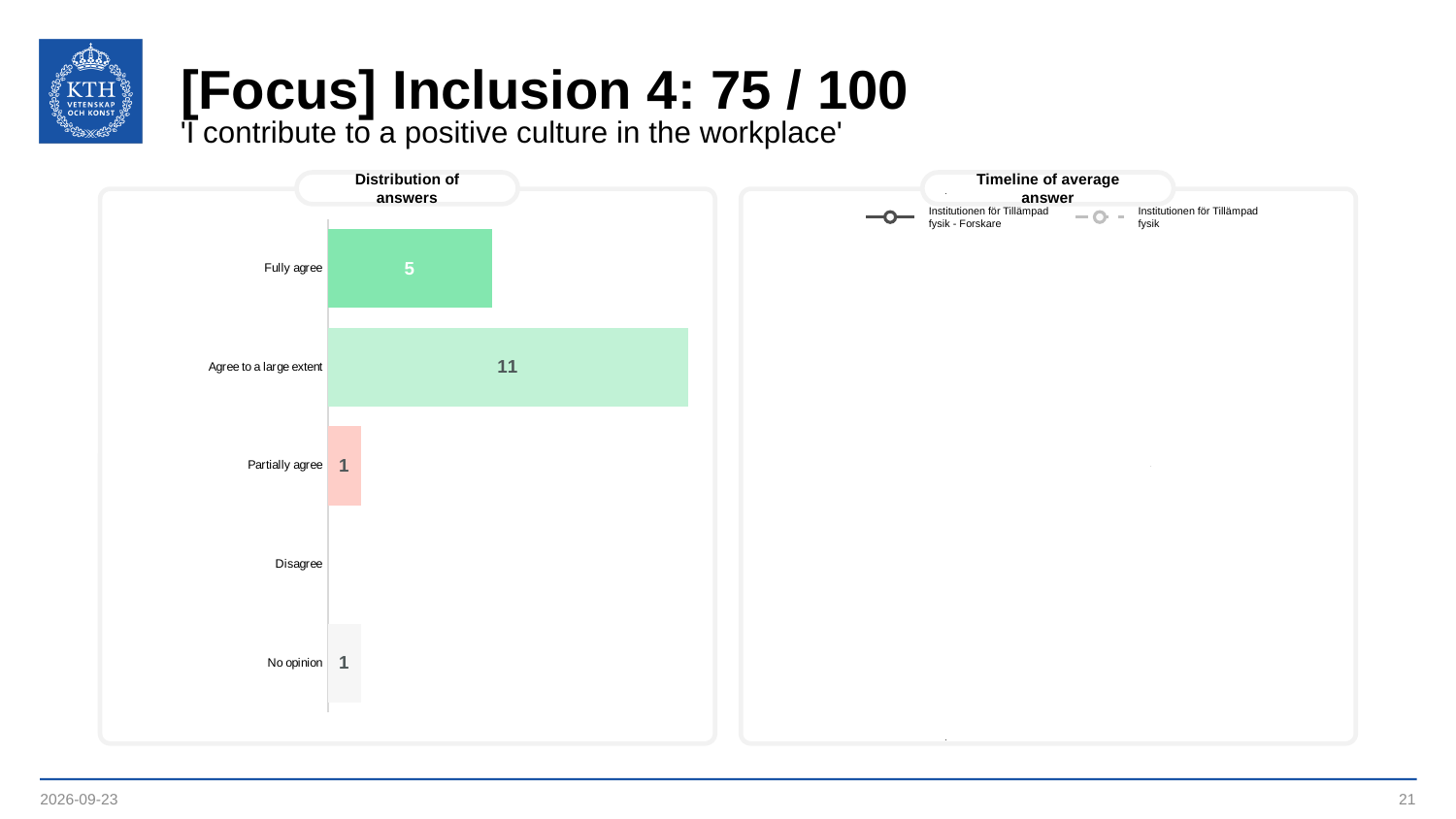
What is the first legend entry in the 'Timeline of average answer' chart? Institutionen för Tillämpad fysik - Forskare In the 'Distribution of answers' chart, what is the value for 'Fully agree'? 5 In the 'Distribution of answers' chart, what is the difference between the values for 'Agree to a large extent' and 'Fully agree'? 6 What kind of chart is the 'Distribution of answers' chart? Bar chart How many series does the legend of the 'Timeline of average answer' chart list? 2 In the 'Distribution of answers' chart, which is larger: the value for 'Fully agree' or the value for 'Partially agree'? Fully agree In the 'Distribution of answers' chart, what is the value for 'Agree to a large extent'? 11 What is the title of the chart on the left side of the slide? Distribution of answers In the 'Distribution of answers' chart, what is the value for 'Partially agree'? 1 In the 'Distribution of answers' chart, what is the value for 'No opinion'? 1 How many categories are shown in the 'Distribution of answers' chart? 5 In the 'Distribution of answers' chart, which category has the highest value? Agree to a large extent